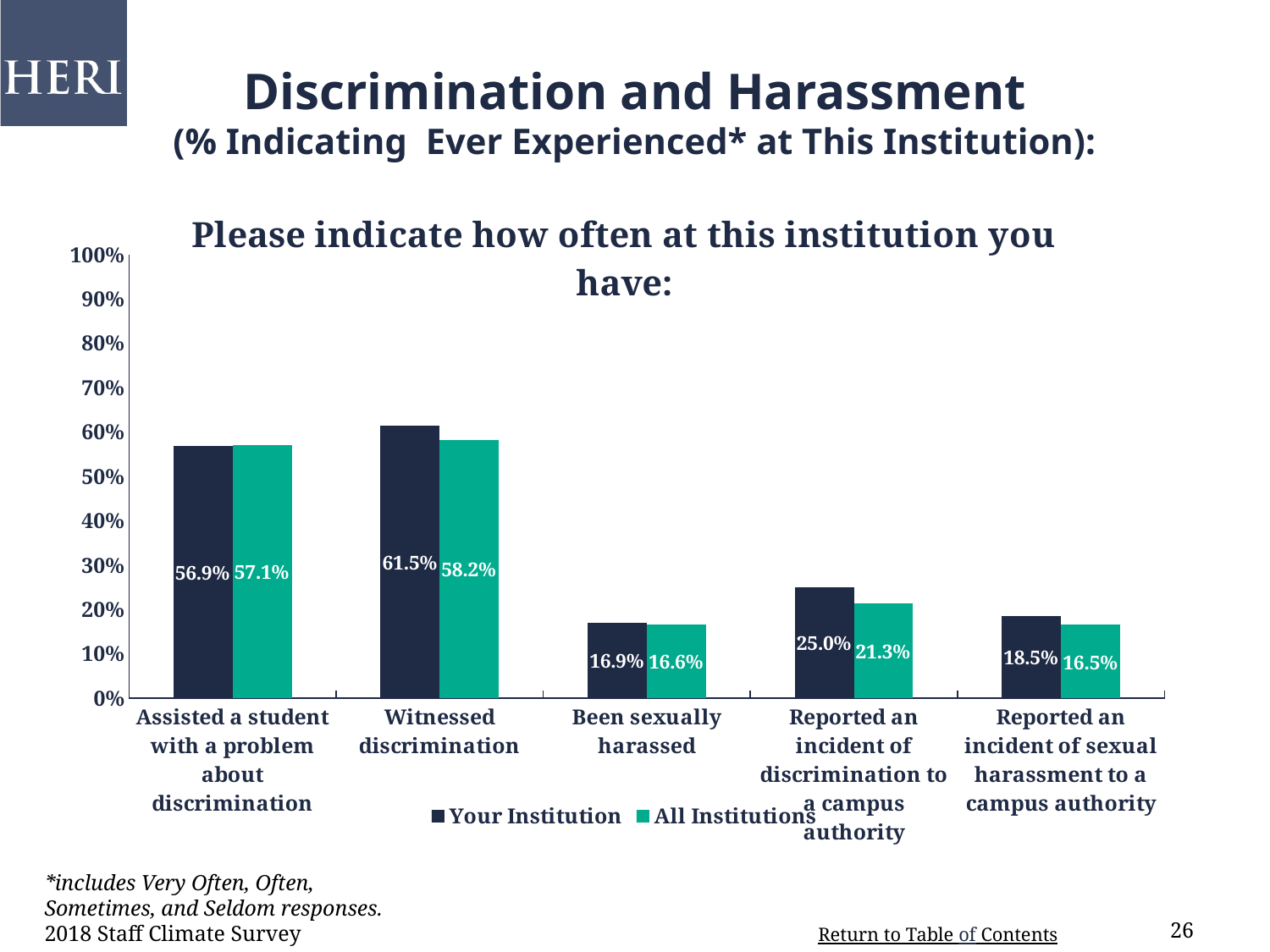
What is the difference between Your Institution and All Institutions for "Witnessed discrimination"? 3.3% For "Assisted a student with a problem about discrimination", which is larger: Your Institution or All Institutions? All Institutions What is the value for All Institutions for "Reported an incident of discrimination to a campus authority"? 21.3% What is the value for Your Institution for "Witnessed discrimination"? 61.5% Which category has the lowest value for All Institutions? Reported an incident of sexual harassment to a campus authority What is the value for Your Institution for "Been sexually harassed"? 16.9% How many categories are shown on the x axis? 5 Is the value for Your Institution for "Reported an incident of sexual harassment to a campus authority" greater or less than 20%? less Which category has the highest value for Your Institution? Witnessed discrimination How many series does the legend list? 2 What is the difference between Your Institution and All Institutions for "Reported an incident of discrimination to a campus authority"? 3.7% What kind of chart is shown on the slide? bar chart